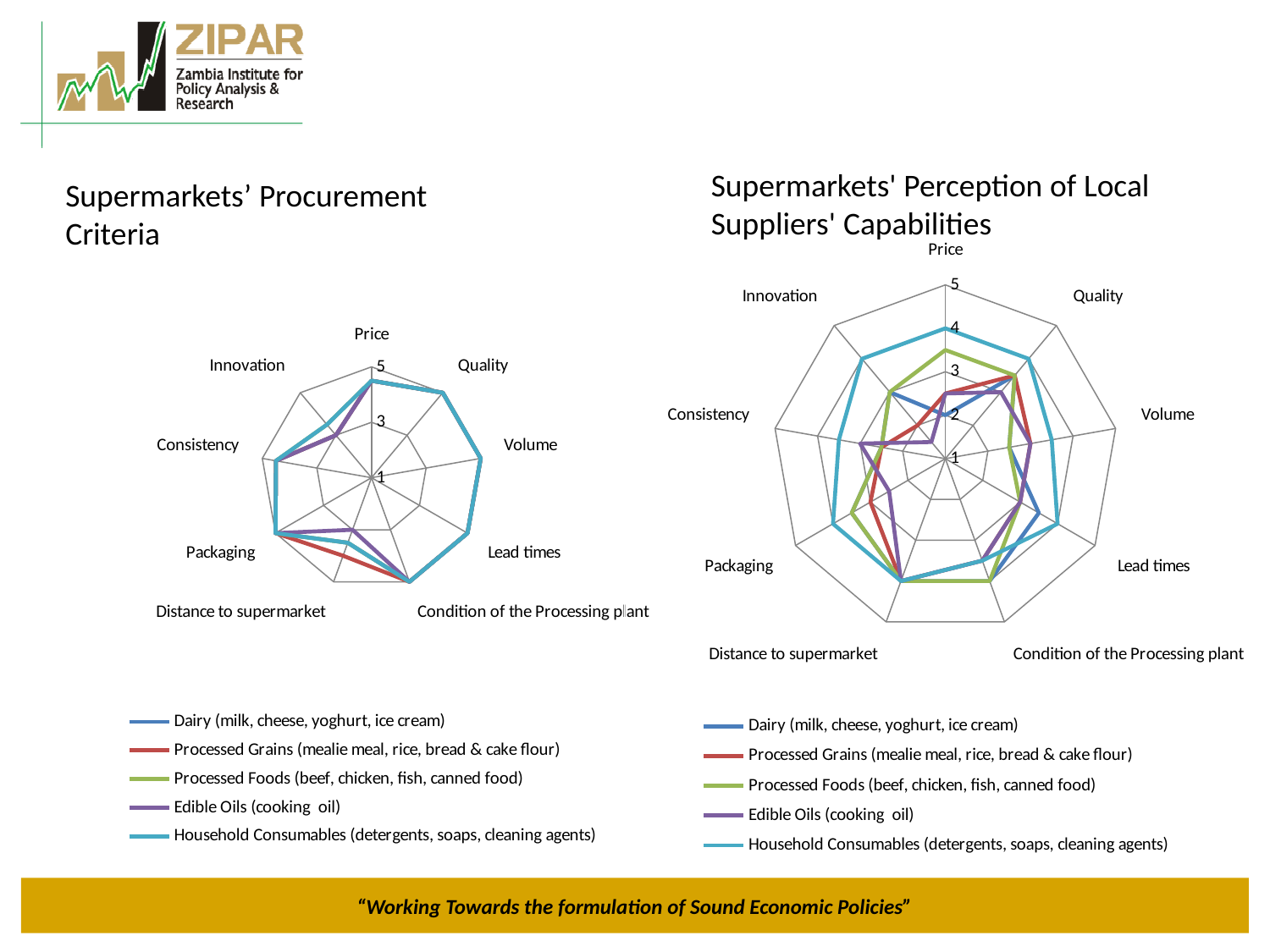
What kind of chart is the 'Supermarkets' Procurement Criteria' chart on the left? Radar chart On the 'Supermarkets' Perception of Local Suppliers' Capabilities' chart, is the value for Household Consumables on the Price axis greater or less than 3? greater On the 'Supermarkets' Procurement Criteria' chart, is the value for Household Consumables on the Volume axis greater or less than 3? greater Which series is shown in green in the legend of the 'Supermarkets' Perception of Local Suppliers' Capabilities' chart? Processed Foods (beef, chicken, fish, canned food) How many series does the legend of the 'Supermarkets' Perception of Local Suppliers' Capabilities' chart list? 5 How many series does the legend of the 'Supermarkets' Procurement Criteria' chart list? 5 How many criteria (axes) are plotted on the 'Supermarkets' Procurement Criteria' chart? 9 On the 'Supermarkets' Perception of Local Suppliers' Capabilities' chart, is the value for Dairy on the Price axis greater or less than 3? less What kind of chart is the 'Supermarkets' Perception of Local Suppliers' Capabilities' chart on the right? Radar chart On the 'Supermarkets' Perception of Local Suppliers' Capabilities' chart, which is larger on the Price axis: Household Consumables or Dairy? Household Consumables What is the maximum value shown on the axis scale of the 'Supermarkets' Procurement Criteria' chart? 5